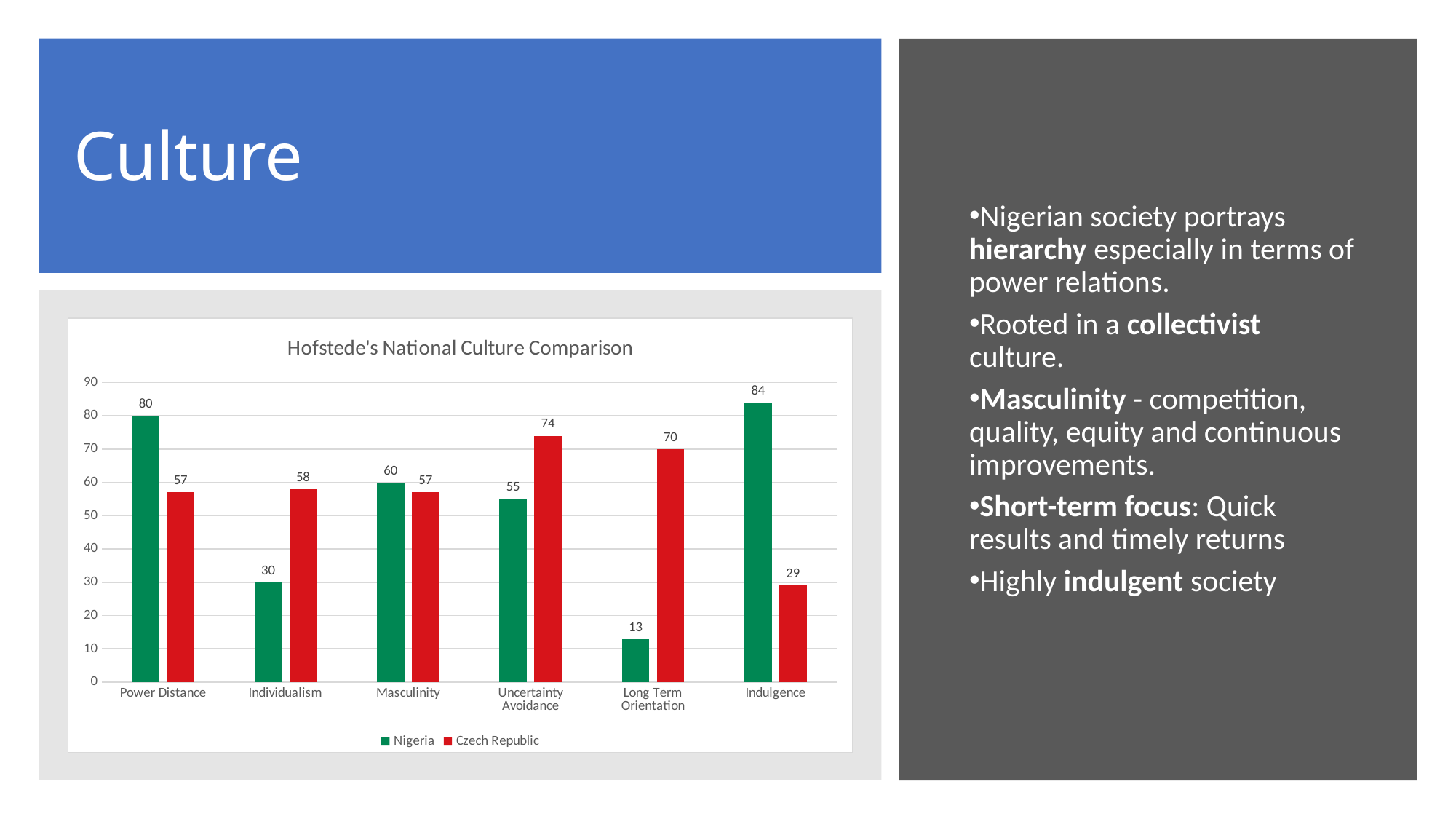
What is the value for the Czech Republic on Uncertainty Avoidance? 74 How many series does the legend list? 2 What is the value for Nigeria on Long Term Orientation? 13 Which category has the lowest value for the Czech Republic? Indulgence Which category has the highest value for Nigeria? Indulgence Which is larger on Individualism, Nigeria or the Czech Republic? Czech Republic What kind of chart is shown on the slide? Bar chart What is the title of the chart? Hofstede's National Culture Comparison What is the difference between Nigeria and the Czech Republic on Long Term Orientation? 57 How many categories are shown on the x axis? 6 Is the value for Nigeria on Uncertainty Avoidance greater or less than 60? less What is the value for Nigeria on Power Distance? 80